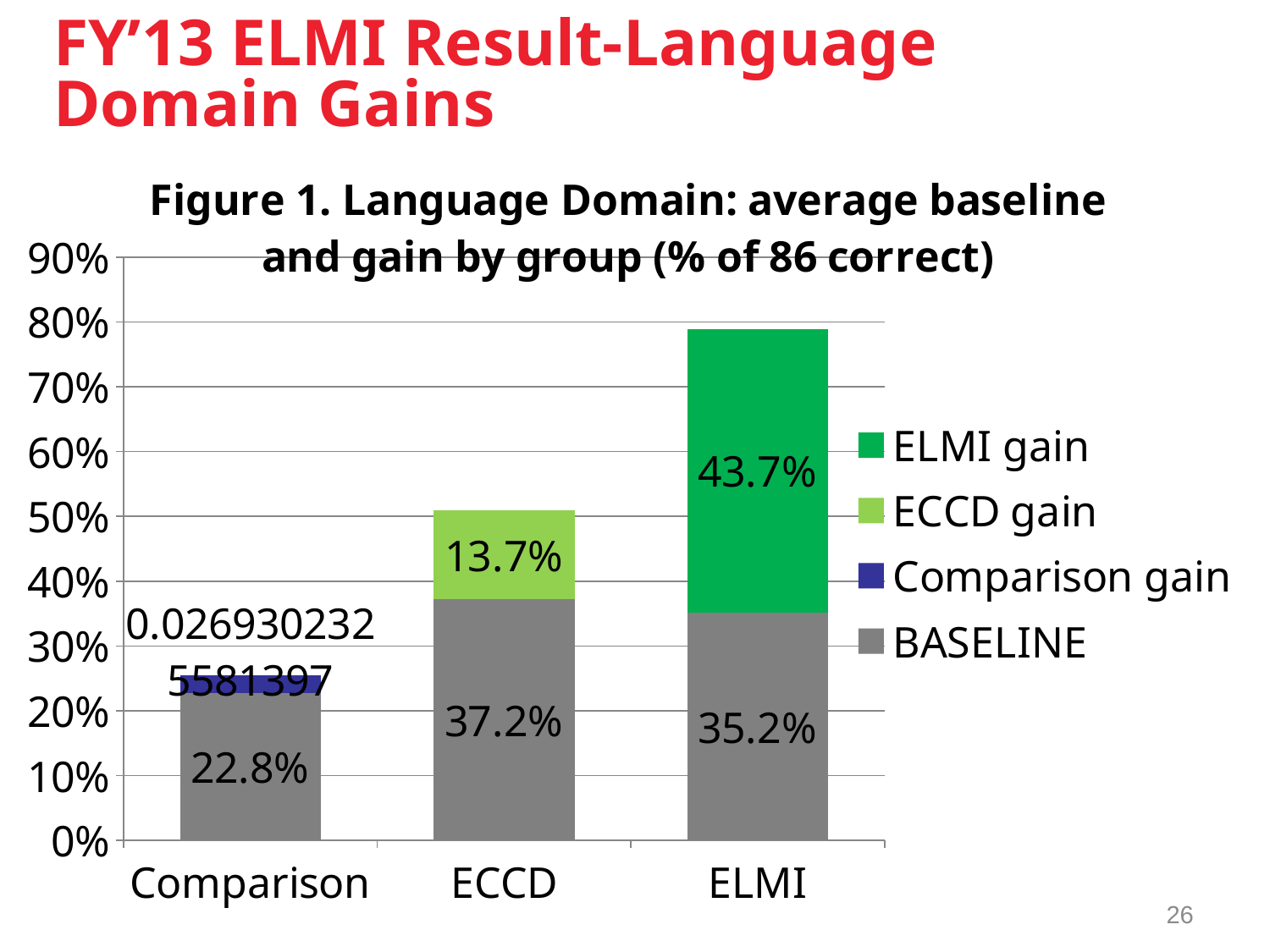
Which group has the lowest BASELINE value? Comparison What is the BASELINE value for ECCD? 37.2% What is the ECCD gain value shown on the ECCD bar? 13.7% What is the total of the ELMI stacked bar (BASELINE plus ELMI gain)? 78.9% What is the difference between the ELMI gain (43.7%) and the ECCD gain (13.7%)? 30.0% How many series does the legend list? 4 Which group has the highest BASELINE value? ECCD What is the BASELINE value for the Comparison group? 22.8% What is the ELMI gain value shown on the ELMI bar? 43.7% Is the total height of the ELMI stacked bar greater or less than 70%? greater How many groups are shown on the x axis? 3 Which is larger, the BASELINE for ECCD or the BASELINE for ELMI? ECCD